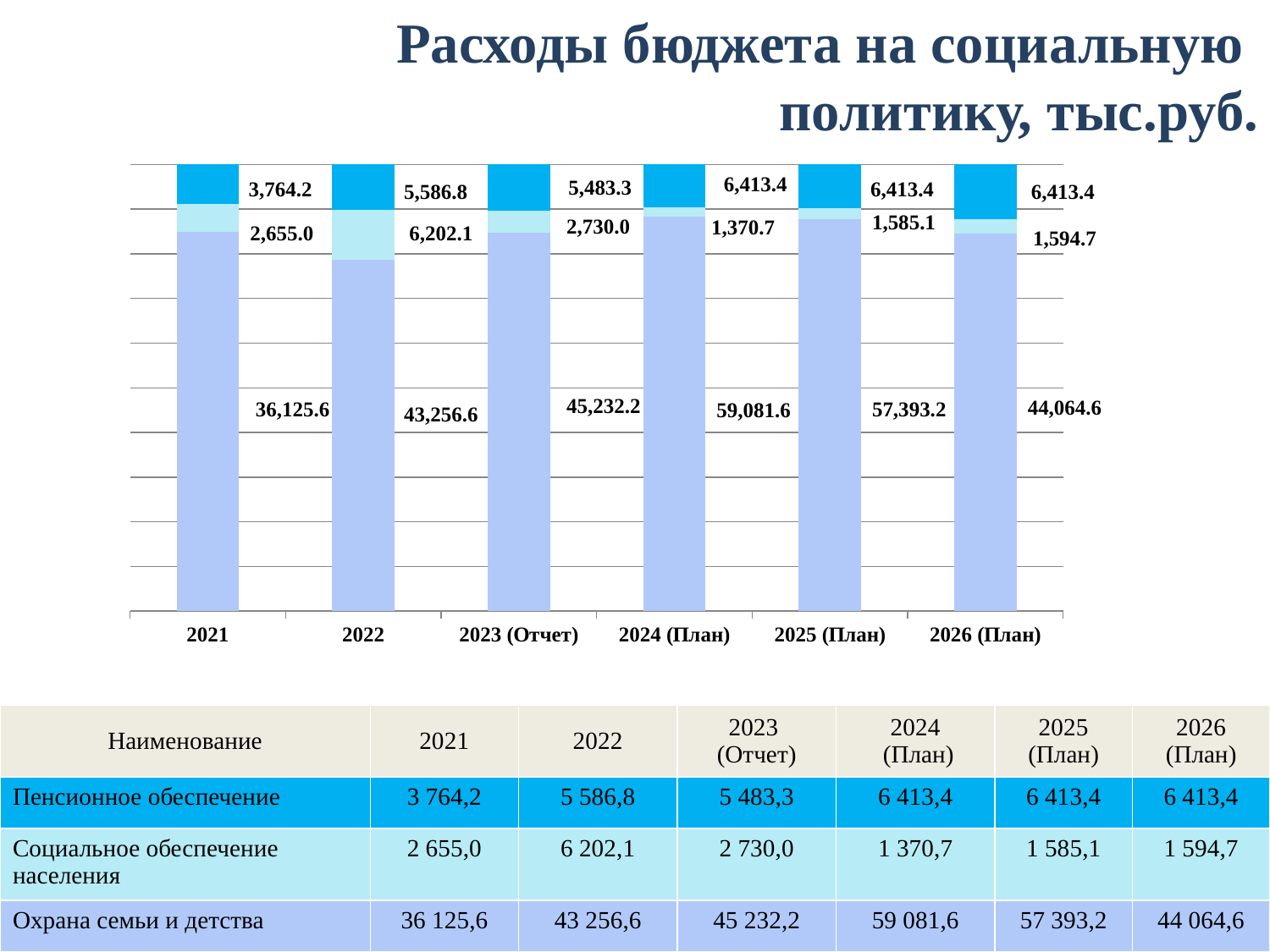
In which year is the bottom segment (Охрана семьи и детства) the lowest? 2021 What is the value of the bottom segment (Охрана семьи и детства) for 2024 (План) in the chart? 59,081.6 Which is larger: the middle segment value for 2022 or for 2023 (Отчет)? 2022 What is the total of the stacked bar for 2021? 42,544.8 What is the difference between the bottom segment values for 2024 (План) and 2023 (Отчет)? 13,849.4 How many categories (years) are shown on the x axis of the chart? 6 What is the title of the chart on the slide? Расходы бюджета на социальную политику, тыс.руб. What is the value of the middle segment (Социальное обеспечение населения) for 2025 (План) in the chart? 1,585.1 What type of chart is shown on the slide? stacked bar chart What is the total of the stacked bar for 2024 (План)? 66,865.7 What is the value of the top segment (Пенсионное обеспечение) for 2022 in the chart? 5,586.8 In which year is the bottom segment (Охрана семьи и детства) the highest? 2024 (План)